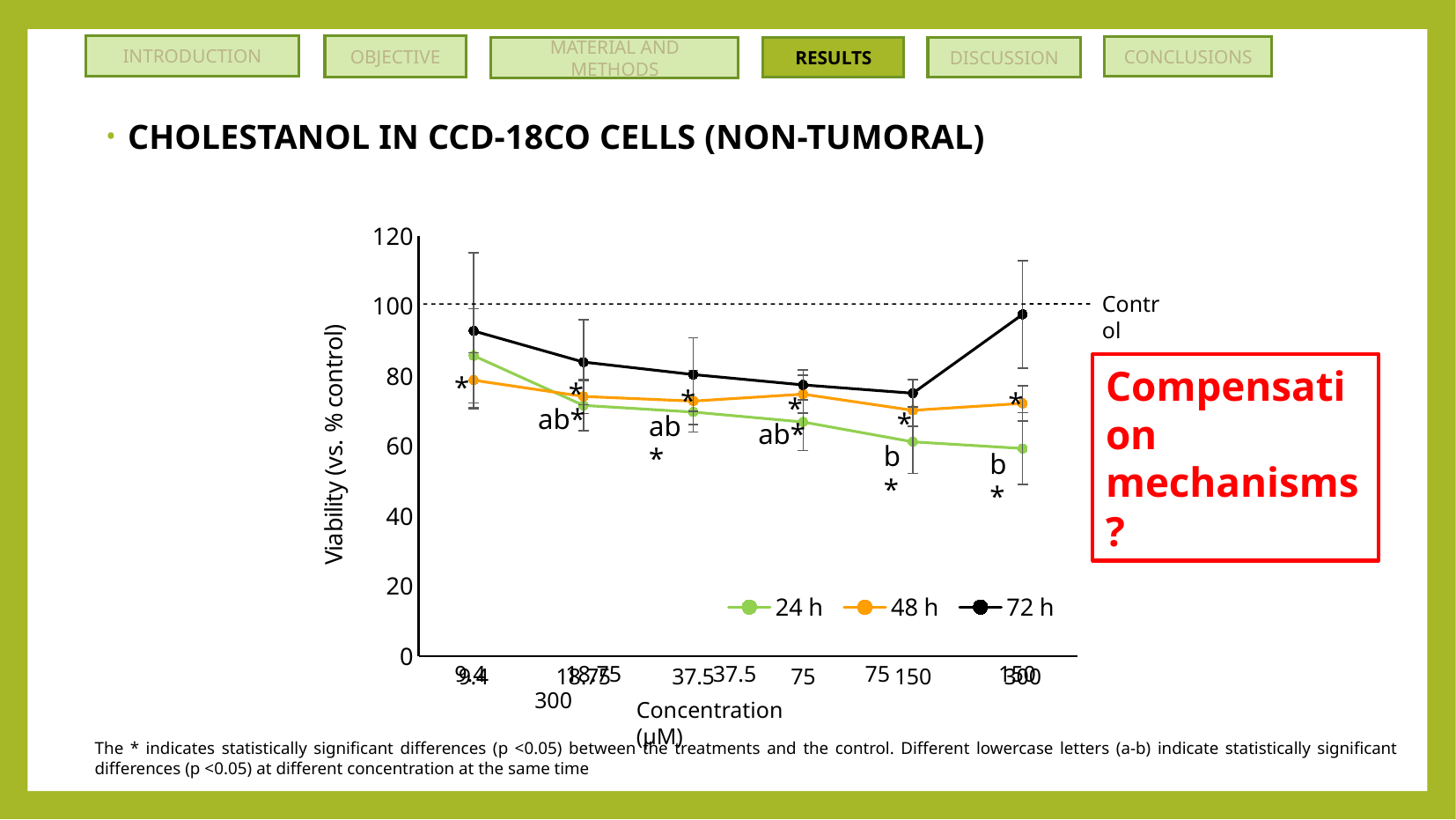
Is the value for 24 h at 150 µM greater or less than 80? less How many concentration points are plotted along the x axis? 6 How many series does the legend list? 3 Does the 24 h series rise or fall as concentration increases along the x axis? fall At 300 µM, which series has the higher viability, 24 h or 72 h? 72 h Is the value for 72 h at 300 µM greater or less than 80? greater Is the value for 72 h at 9.4 µM greater or less than 80? greater Which series has the highest viability at 300 µM? 72 h Which series has the lowest viability at 150 µM? 24 h What kind of chart is shown on the slide? line chart What value does the dashed horizontal line labelled Control sit at on the y axis? 100